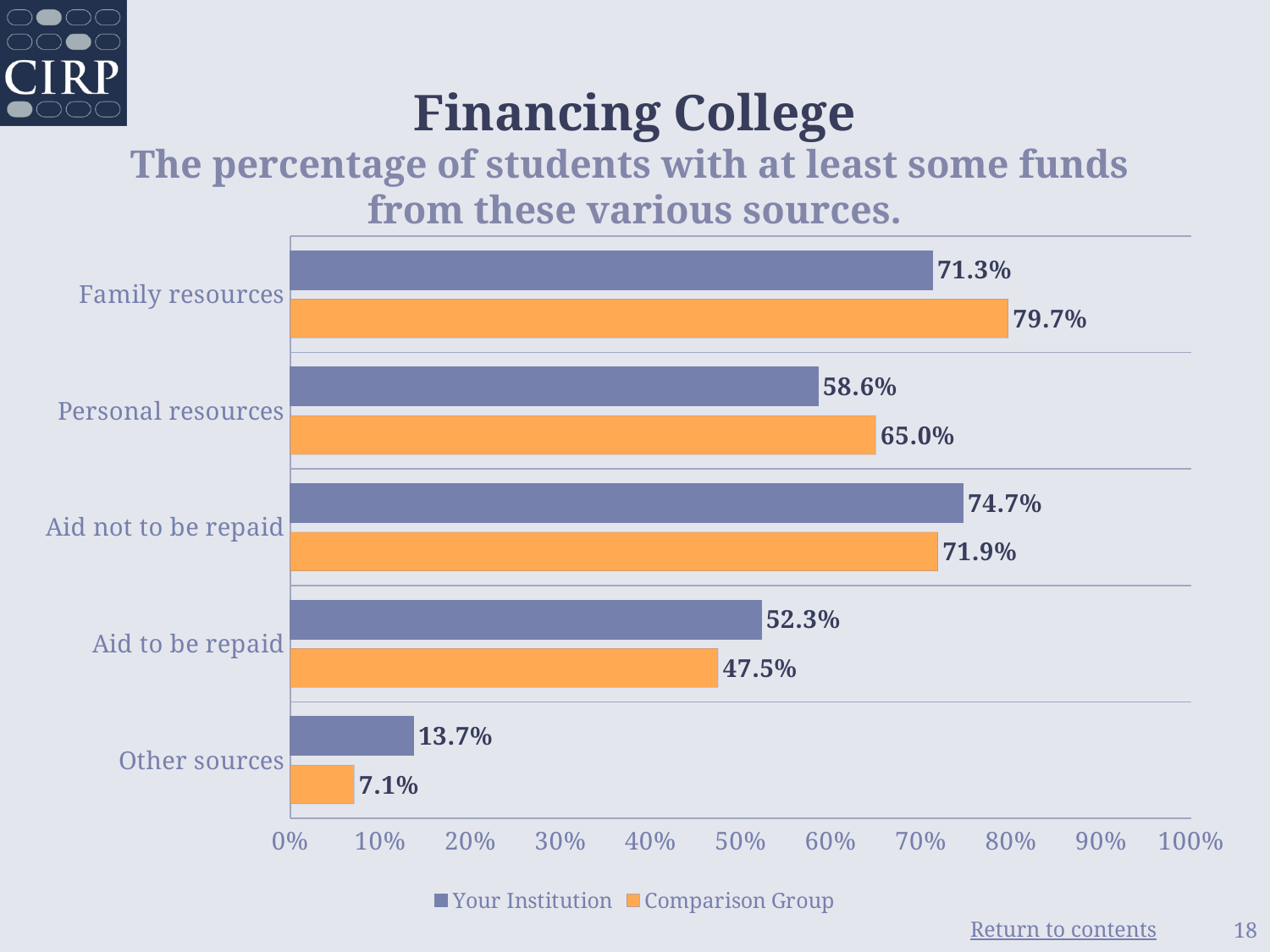
What is the value for Comparison Group for Other sources? 7.1% What kind of chart is shown on the slide? bar chart Which category has the lowest value for Comparison Group? Other sources What colour are the Comparison Group bars? orange How many series does the legend list? 2 Which is larger for Aid to be repaid: Your Institution or Comparison Group? Your Institution What is the value for Comparison Group for Personal resources? 65.0% How many categories are shown on the chart? 5 What is the difference between the Comparison Group and Your Institution values for Family resources? 8.4% Which category has the highest value for Your Institution? Aid not to be repaid What is the value for Your Institution for Family resources? 71.3% Is the value for Your Institution for Personal resources greater or less than 50%? greater